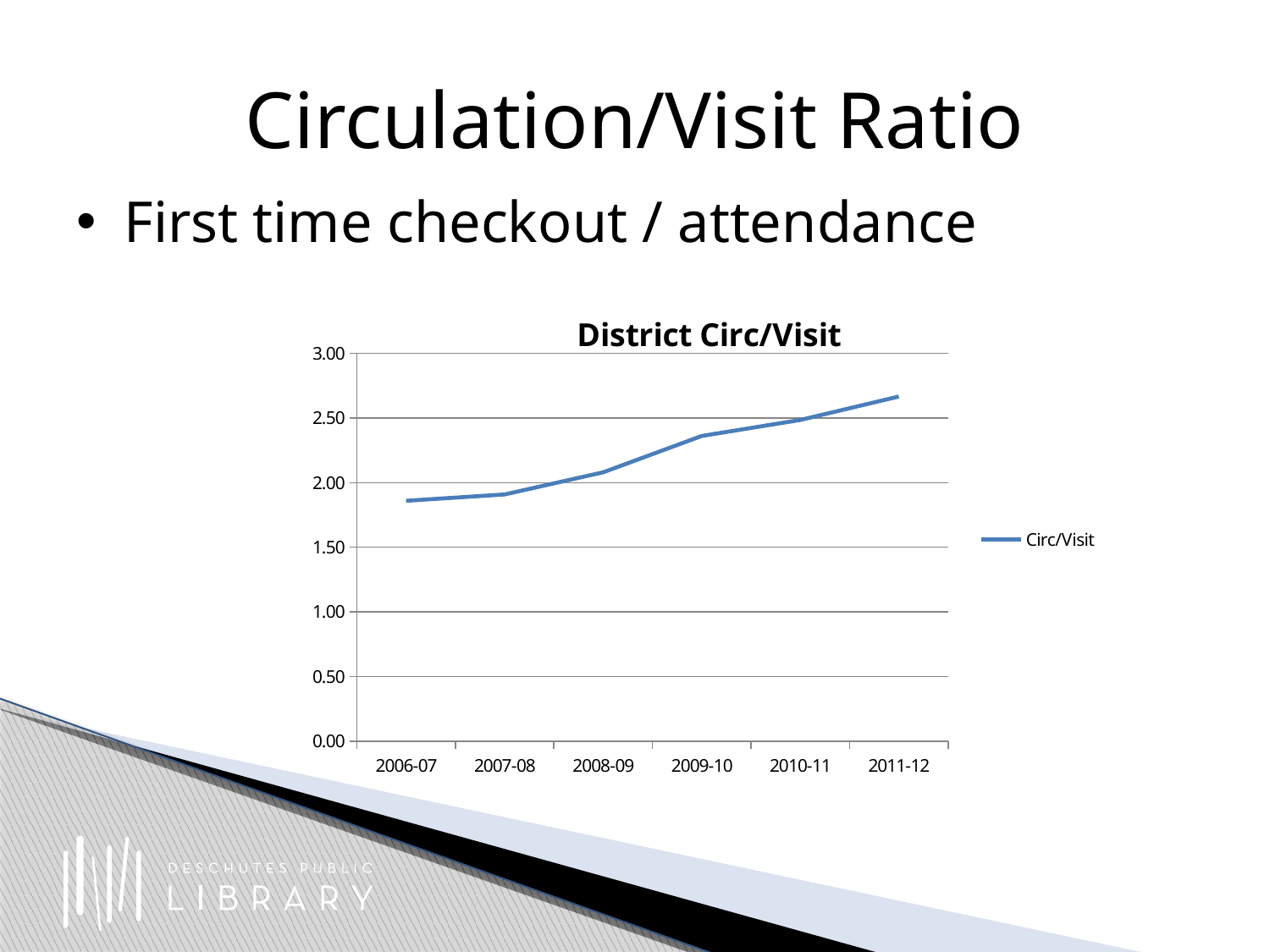
Is the Circ/Visit value for 2011-12 greater or less than 2.50? greater Do the Circ/Visit values rise or fall from 2006-07 to 2011-12? Rise What is the name of the series shown in the legend? Circ/Visit Is the Circ/Visit value for 2006-07 greater or less than 2.00? less Which year has the larger Circ/Visit value, 2007-08 or 2009-10? 2009-10 How many fiscal years are plotted on the x axis? 6 Which year has the highest Circ/Visit value? 2011-12 What is the title of the chart? District Circ/Visit What kind of chart is shown on the slide? Line chart How many series does the legend list? 1 Is the Circ/Visit value for 2009-10 greater or less than 2.00? greater Which year has the lowest Circ/Visit value? 2006-07